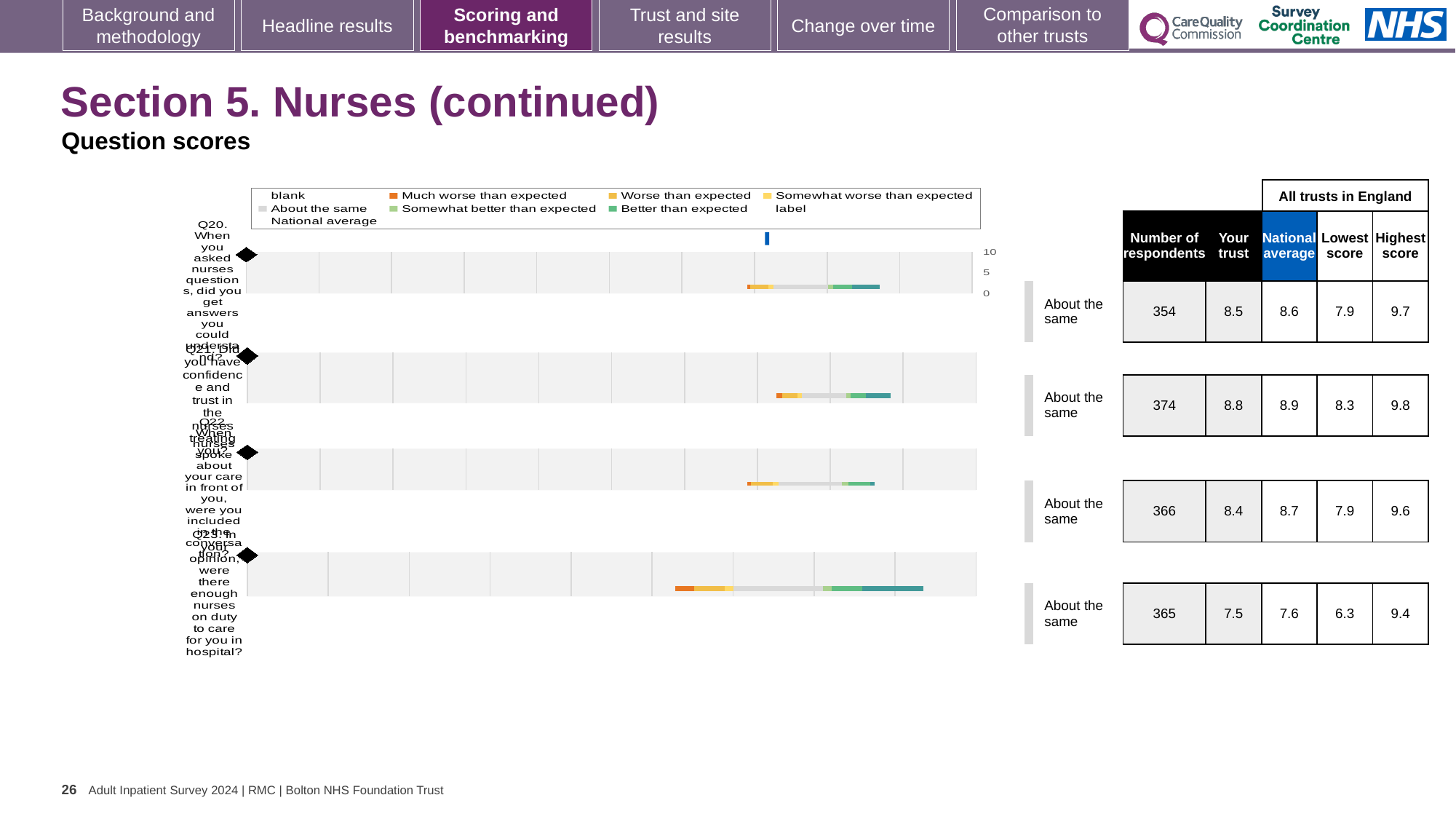
For the Q23 chart (were there enough nurses on duty to care for you in hospital), what is the lowest score among all trusts in England? 6.3 Which question chart has the lowest 'Your trust' score? Q23 Is the 'Your trust' score larger for the Q21 chart or the Q23 chart? Q21 For the Q23 chart, what is the difference between the highest score and the lowest score among all trusts in England? 3.1 For the Q21 chart (did you have confidence and trust in the nurses treating you), what is the national average score? 8.9 For the Q20 chart (when you asked nurses questions, did you get answers you could understand), what is the 'Your trust' score? 8.5 Which legend entry is shown in dark orange on the charts? Much worse than expected Which question chart has the highest 'Your trust' score? Q21 What kind of chart is used to show the question scores on this slide? bar chart How many question charts (Q20 to Q23) are shown on the slide? 4 What is the highest value shown on the score axis of the charts? 10 For the Q22 chart (when nurses spoke about your care in front of you, were you included in the conversation), how many respondents are there? 366